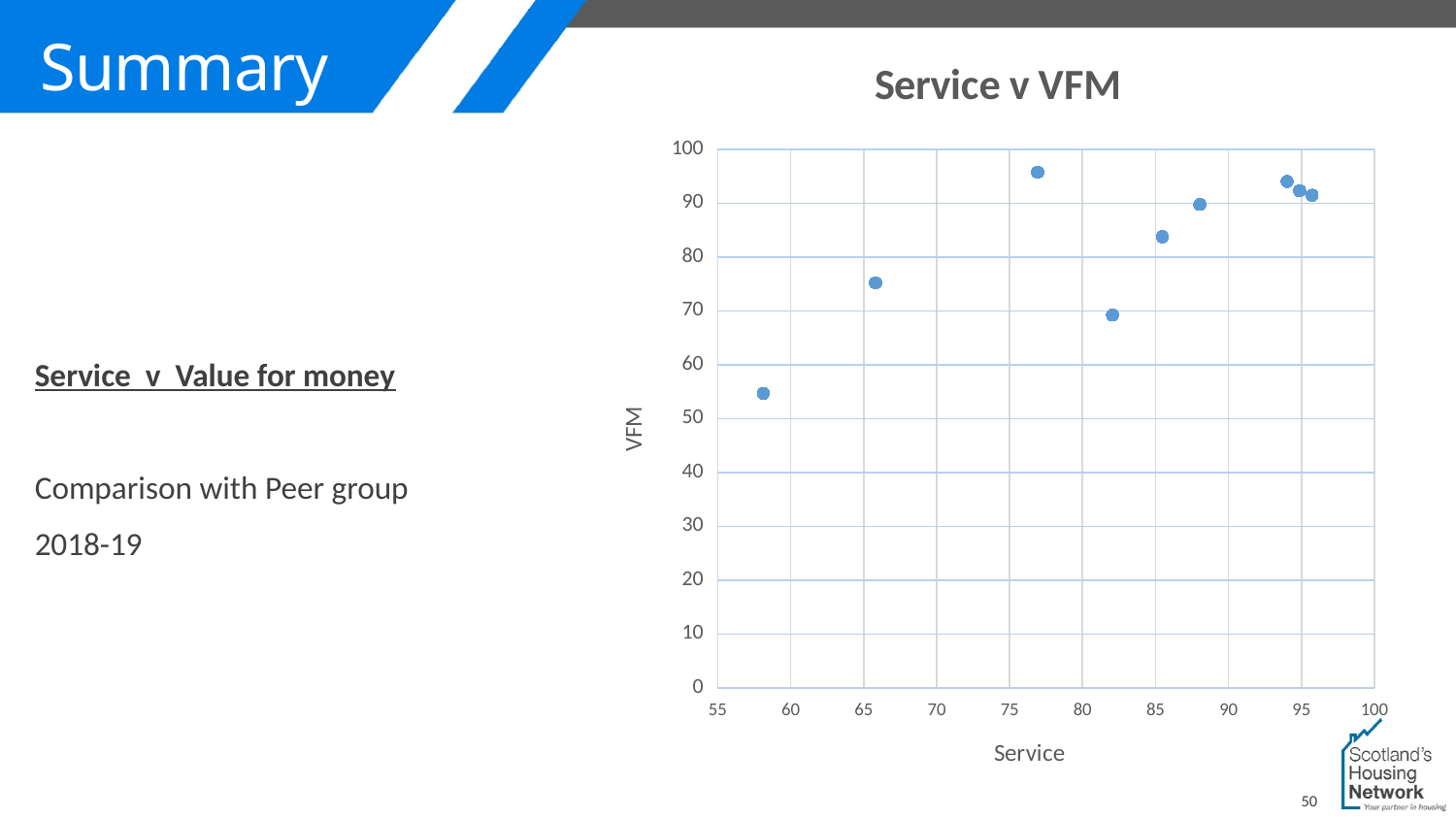
Is the VFM value of the point at a Service score of about 88 greater or less than 80? greater Is the VFM value of the point at a Service score of about 82 greater or less than 60? greater How many data points are plotted on the chart? 9 Is the VFM value of the point with the lowest Service score greater or less than 60? less Do VFM values generally rise or fall as Service increases along the x axis? rise What is the title of the chart? Service v VFM Which point has the lower VFM value: the one at a Service score of about 58 or the one at a Service score of about 88? the one at about 58 What kind of chart is shown on the slide? scatter chart What is the label of the horizontal axis of the chart? Service